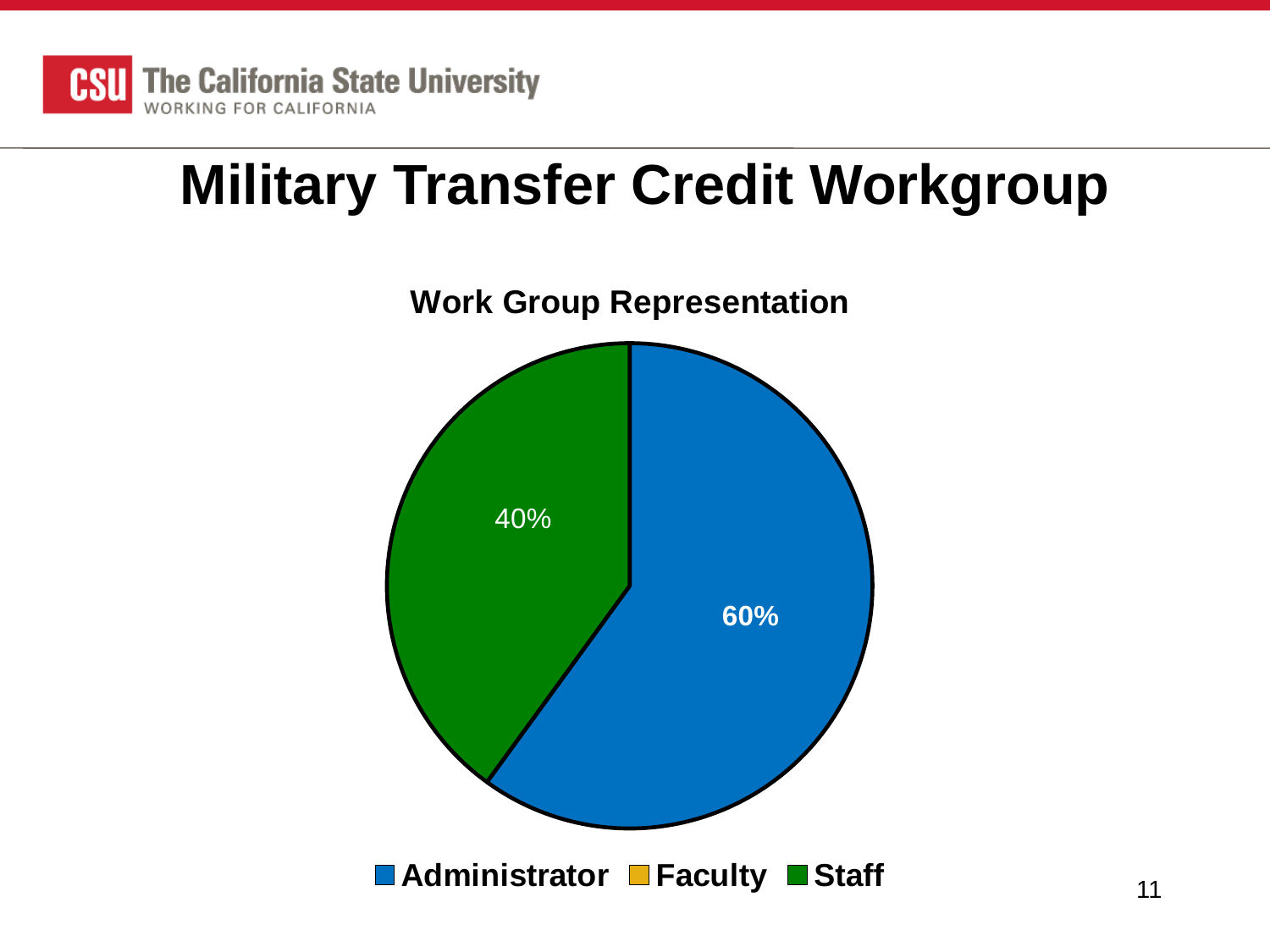
What share of the pie does Staff represent? 40% What colour is the Staff slice? Green What share of the pie does Administrator represent? 60% What kind of chart is shown on the slide? Pie chart Which category has the largest slice of the pie? Administrator How many entries does the legend list? 3 Which of the two visible slices is smaller, Administrator or Staff? Staff Which is larger, the Administrator share or the Staff share? Administrator What is the difference in percentage points between the Administrator share and the Staff share? 20 percentage points How many slices are visible in the pie? 2 Which legend entry has no visible slice in the pie? Faculty What is the title of the chart? Work Group Representation